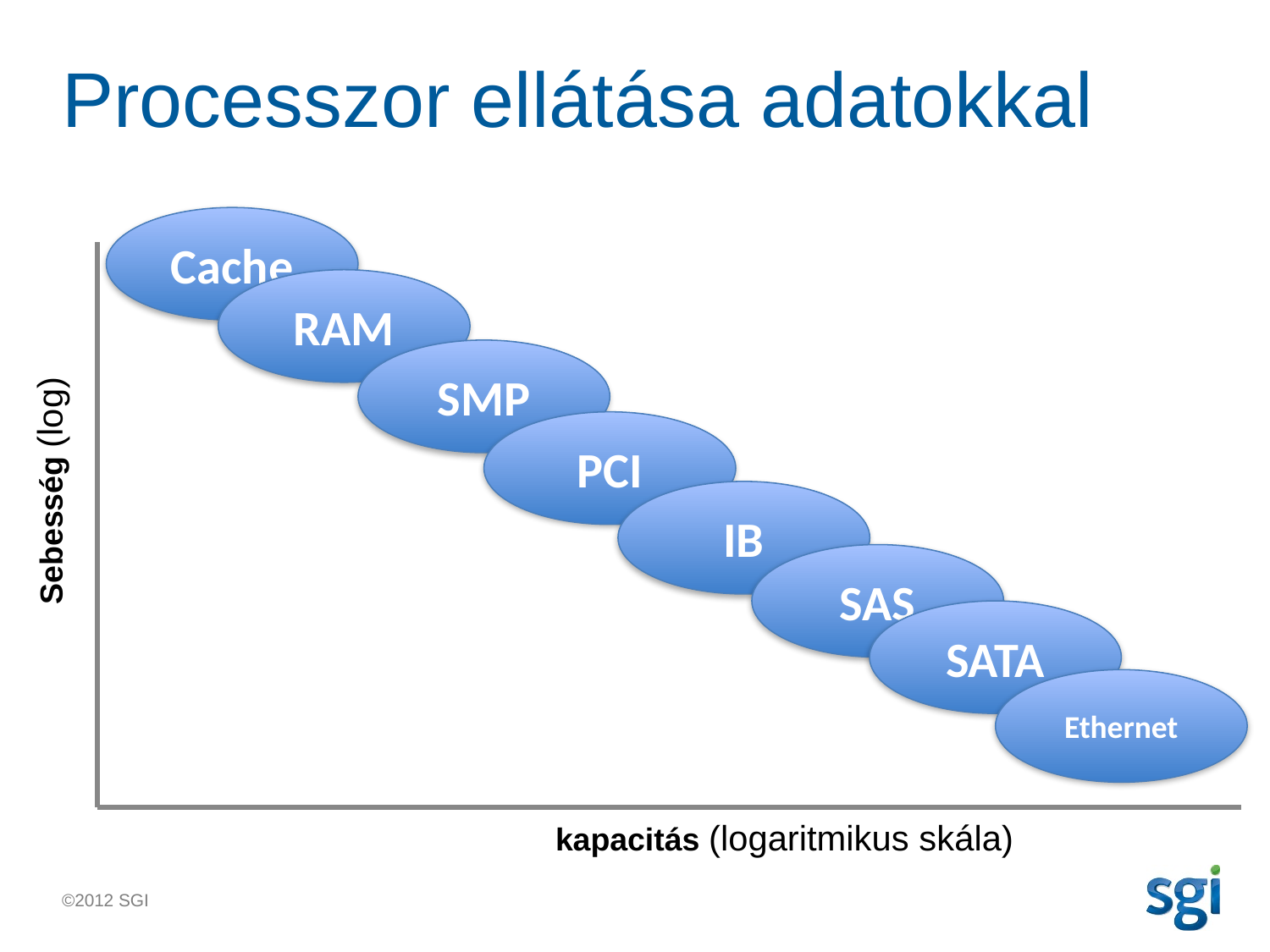
Which item is plotted with the largest capacity (kapacitás)? Ethernet Which is plotted with larger capacity, SAS or IB? SAS As capacity increases along the x axis, does speed rise or fall? fall How many labeled items are plotted on the chart? 8 Which is plotted with higher speed, RAM or PCI? RAM What is the label of the y axis? Sebesség (log) Which item is plotted with the highest speed (Sebesség)? Cache Which item is plotted with the lowest speed (Sebesség)? Ethernet Which item is plotted immediately after SMP along the x axis? PCI Which item is plotted with the smallest capacity (kapacitás)? Cache